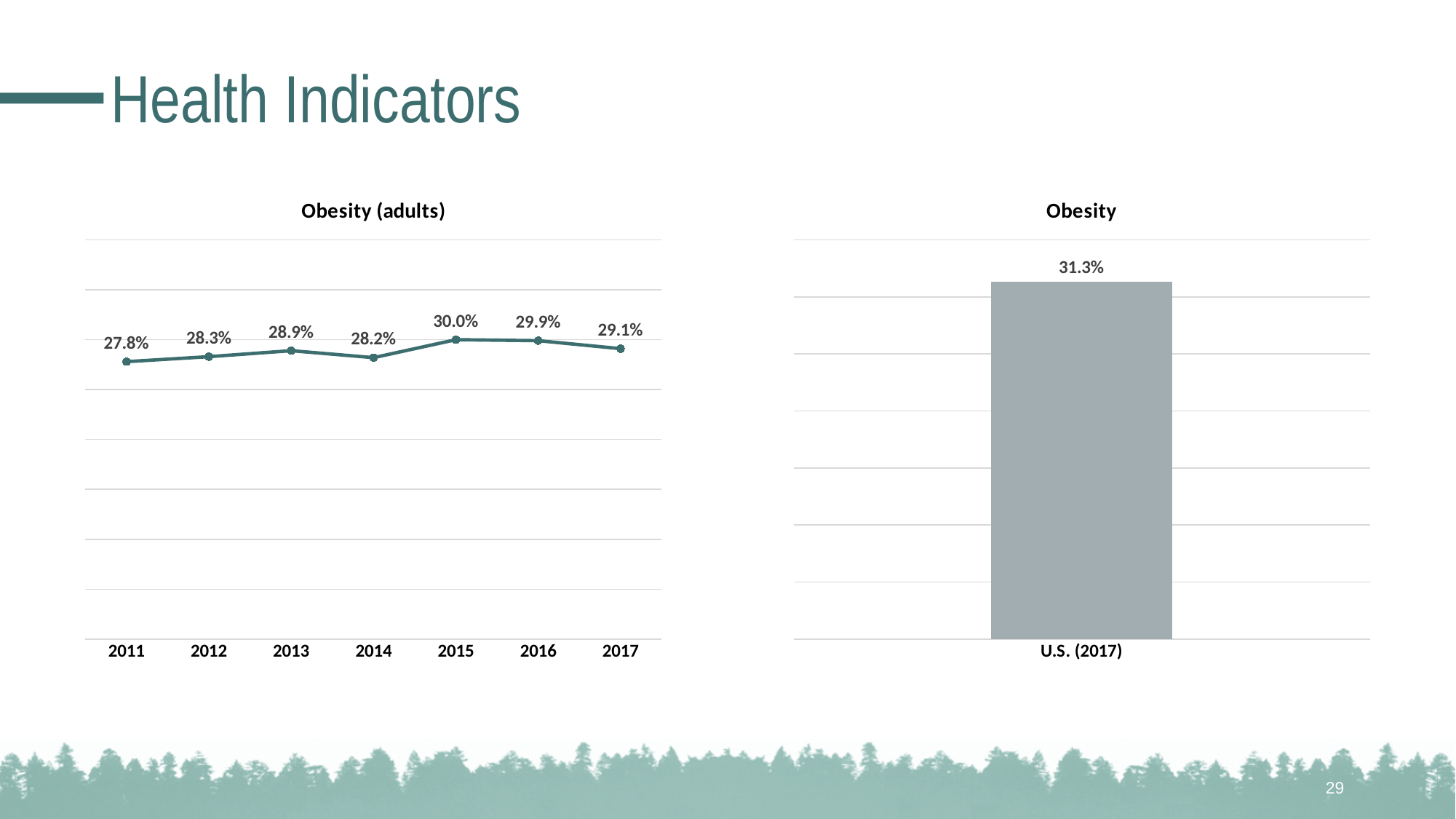
In the "Obesity (adults)" chart, which year has the lowest value? 2011 In the "Obesity (adults)" chart, what is the value for 2011? 27.8% In the "Obesity (adults)" chart, what is the difference between the 2015 value and the 2011 value? 2.2% What is the difference between the U.S. (2017) value in the right chart and the 2017 value in the "Obesity (adults)" chart? 2.2% In the "Obesity (adults)" chart, does the value rise or fall from 2016 to 2017? fall What kind of chart is the "Obesity (adults)" chart? line chart In the "Obesity (adults)" chart, what is the value for 2015? 30.0% In the "Obesity" chart on the right, what is the value for U.S. (2017)? 31.3% In the "Obesity (adults)" chart, which is larger, the value for 2013 or the value for 2014? 2013 What kind of chart is the "Obesity" chart on the right? bar chart In the "Obesity (adults)" chart, which year has the highest value? 2015 How many years are plotted in the "Obesity (adults)" chart? 7